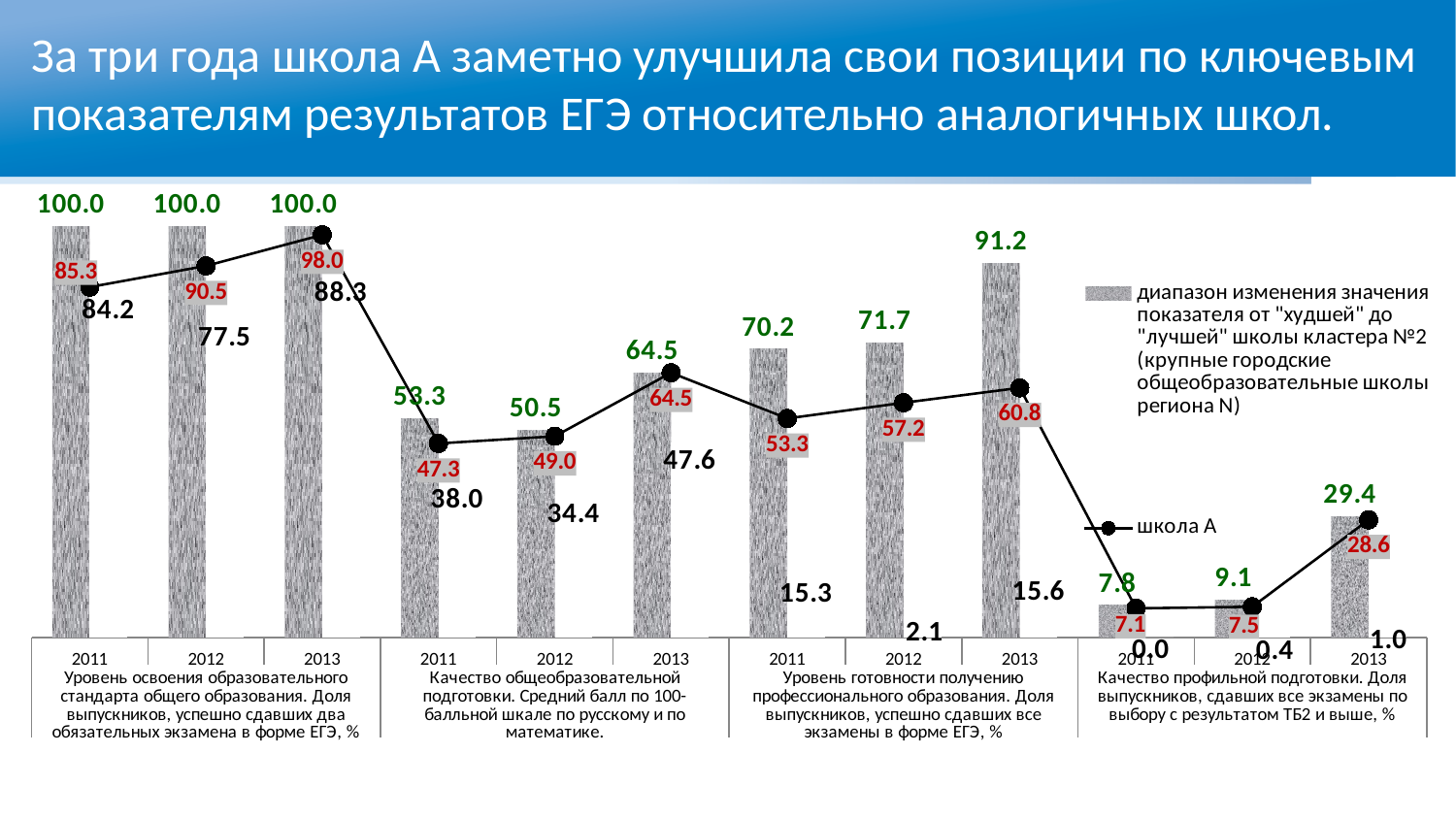
In the group 'Качество общеобразовательной подготовки', is the школа А value for 2012 (49.0) larger or smaller than the value for 2011 (47.3)? larger What kind of chart is shown on the slide? Combined bar and line chart How many entries does the chart legend list? 2 What value does the line for школа А show for 2013 in the group 'Качество профильной подготовки'? 28.6 By how much did the школа А value in the group 'Уровень освоения образовательного стандарта общего образования' change from 2011 (85.3) to 2013 (98.0)? 12.7 What value does the line for школа А show for 2011 in the group 'Качество общеобразовательной подготовки'? 47.3 What value does the line for школа А show for 2013 in the group 'Уровень освоения образовательного стандарта общего образования'? 98.0 What is the upper value of the grey bar for 2013 in the group 'Уровень готовности получению профессионального образования'? 91.2 Does the школа А line rise or fall from 2011 to 2013 within the group 'Уровень готовности получению профессионального образования'? rises How many indicator groups are shown along the x axis of the chart? 4 In the group 'Уровень готовности получению профессионального образования', which year has the lowest value for школа А? 2011 In the group 'Качество профильной подготовки', which year has the highest value for школа А? 2013